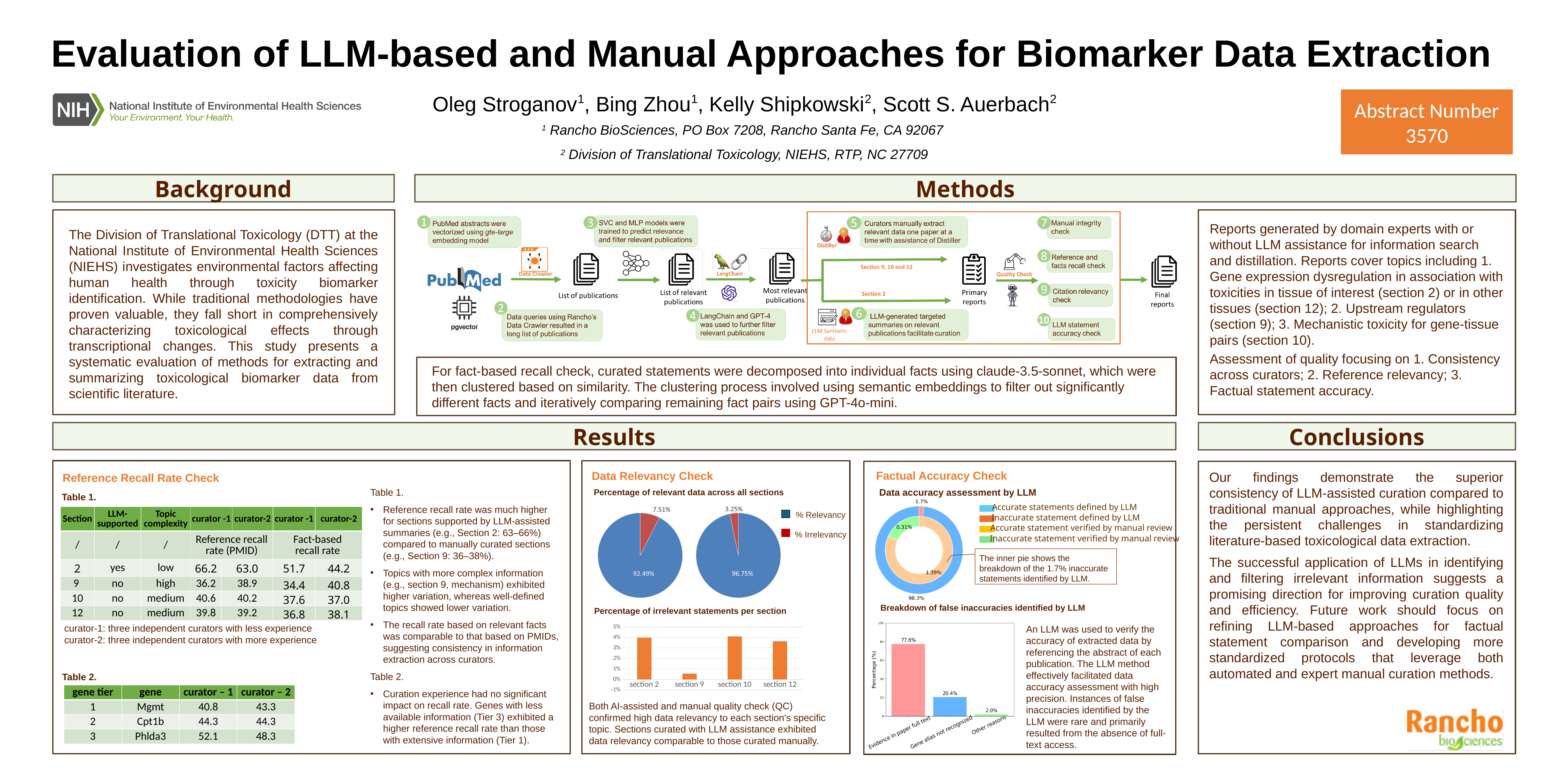
In the 'Breakdown of false inaccuracies identified by LLM' chart, what is the value for 'Evidence in paper full text'? 77.6% In the 'Percentage of relevant data across all sections' charts, what is the % Irrelevancy share in the left pie? 7.51% In the 'Breakdown of false inaccuracies identified by LLM' chart, what is the value for 'Gene alias not recognized'? 20.4% How many entries does the legend of the 'Percentage of relevant data across all sections' charts list? 2 What kind of chart is 'Breakdown of false inaccuracies identified by LLM'? Bar chart In the 'Data accuracy assessment by LLM' chart, what share is labelled for accurate statements defined by LLM on the outer ring? 98.3% In the 'Breakdown of false inaccuracies identified by LLM' chart, how many categories are shown? 3 In the 'Breakdown of false inaccuracies identified by LLM' chart, what is the difference between 'Evidence in paper full text' and 'Gene alias not recognized'? 57.2% In the 'Percentage of irrelevant statements per section' chart, which section has the lowest value? section 9 In the 'Breakdown of false inaccuracies identified by LLM' chart, which category has the lowest value? Other reasons In the 'Percentage of relevant data across all sections' charts, what is the % Relevancy share in the right pie? 96.75% In the 'Percentage of irrelevant statements per section' chart, is the value for section 2 greater or less than 3%? greater